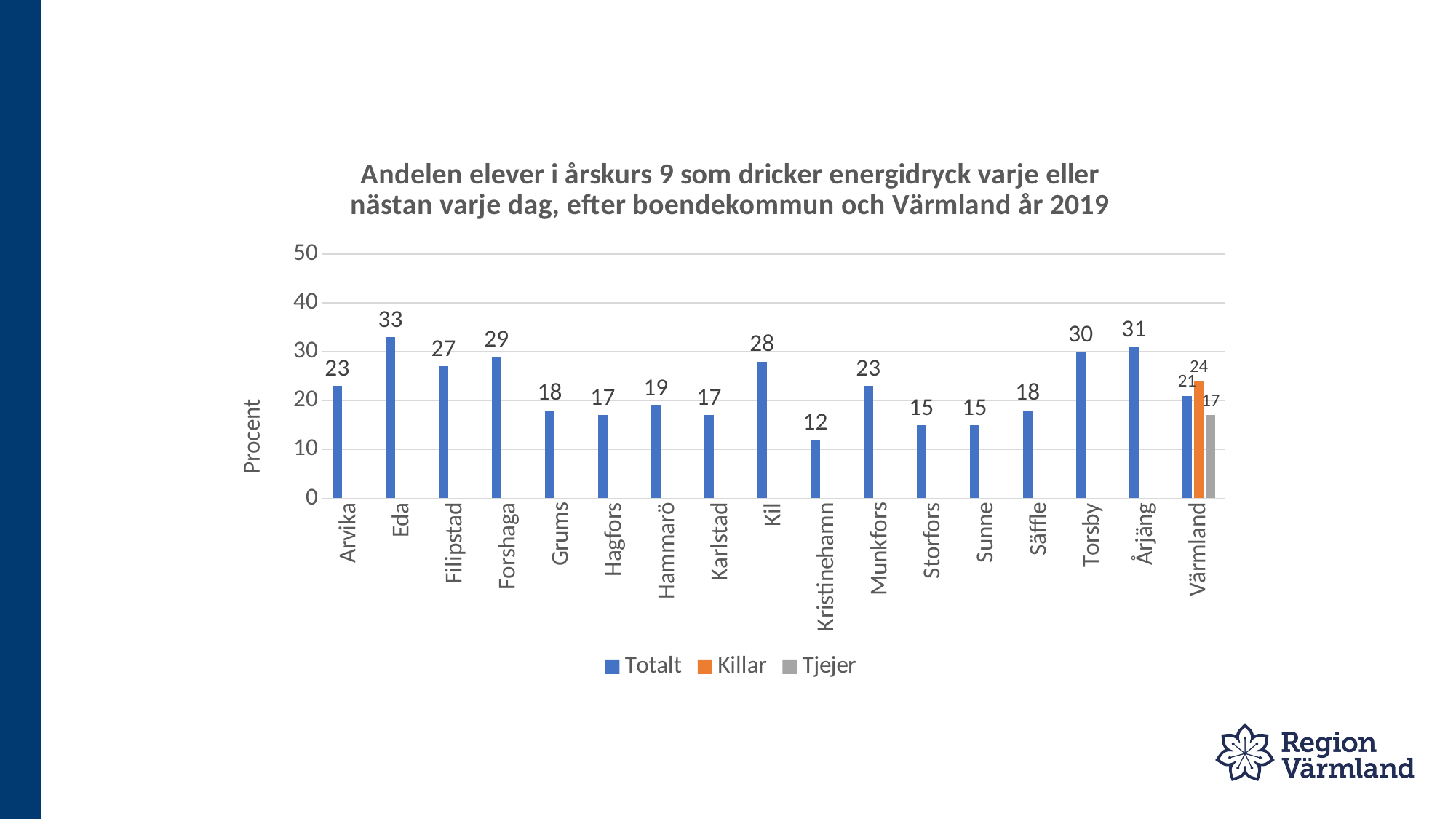
What kind of chart is shown on the slide? bar chart What is the difference between the Totalt values for Eda and Kristinehamn? 21 What is the Tjejer value for Värmland? 17 Which municipality has the lowest Totalt value? Kristinehamn What is the Killar value for Värmland? 24 Which has a higher Totalt value, Torsby or Årjäng? Årjäng How many series does the legend list? 3 Which municipality has the highest Totalt value? Eda What is the label of the y axis? Procent Is the Totalt value for Kil greater or less than 20? greater How many categories are shown on the x axis? 17 What is the Totalt value for Eda? 33